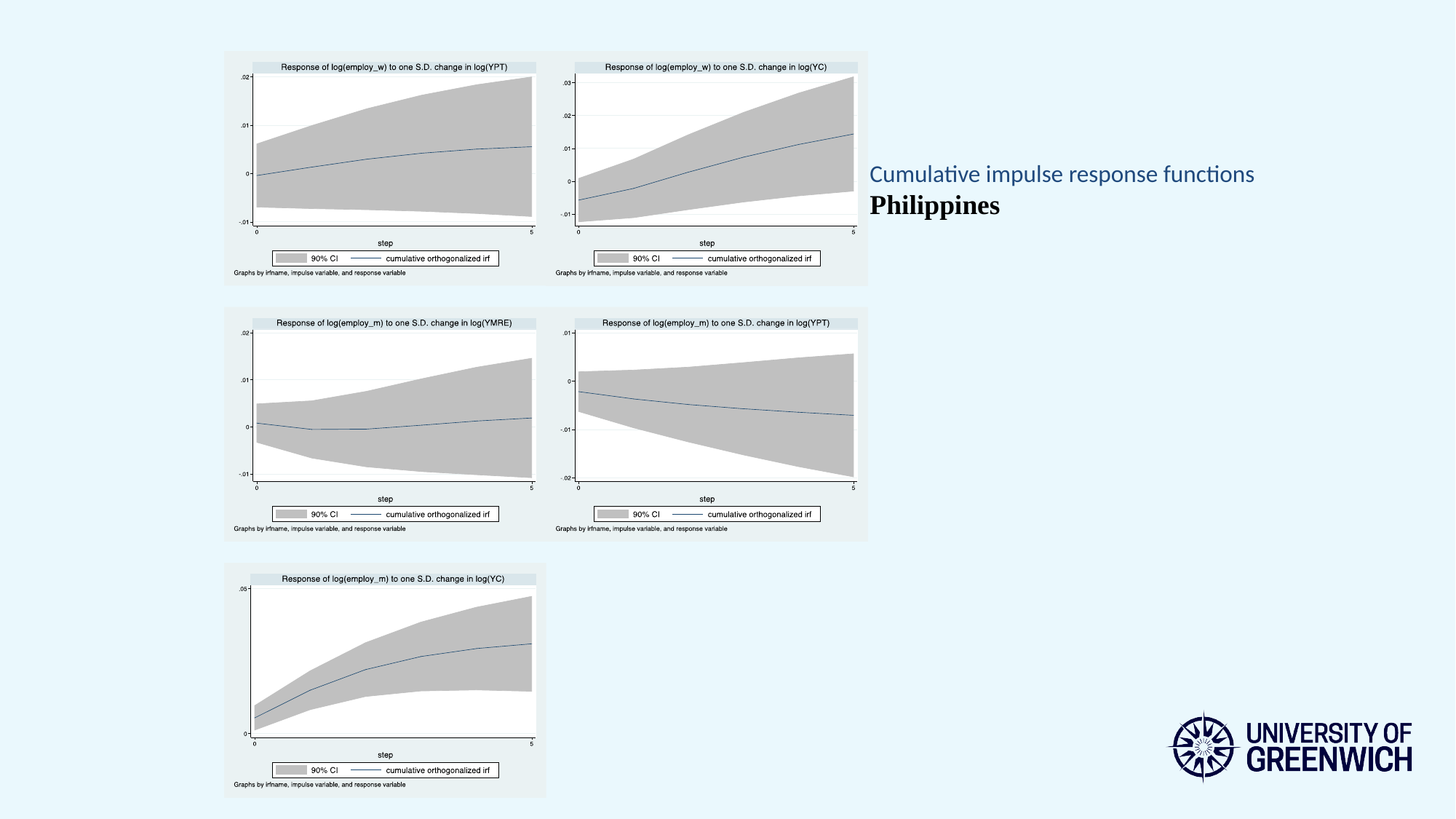
What kind of chart is 'Response of log(employ_w) to one S.D. change in log(YPT)'? line chart In the chart 'Response of log(employ_w) to one S.D. change in log(YC)', is the cumulative orthogonalized irf at step 0 greater or less than 0? less How many impulse response charts are shown on the slide? 5 In the chart 'Response of log(employ_m) to one S.D. change in log(YC)', is the cumulative orthogonalized irf at step 5 greater or less than 0? greater In the chart 'Response of log(employ_w) to one S.D. change in log(YC)', is the cumulative orthogonalized irf at step 5 greater or less than .01? greater In the chart 'Response of log(employ_w) to one S.D. change in log(YC)', does the cumulative orthogonalized irf rise or fall from step 0 to step 5? rises How many entries does the legend list in the chart 'Response of log(employ_m) to one S.D. change in log(YC)'? 2 In the chart 'Response of log(employ_m) to one S.D. change in log(YMRE)', what does the shaded grey area represent according to the legend? 90% CI In the chart 'Response of log(employ_m) to one S.D. change in log(YPT)', does the cumulative orthogonalized irf rise or fall from step 0 to step 5? falls